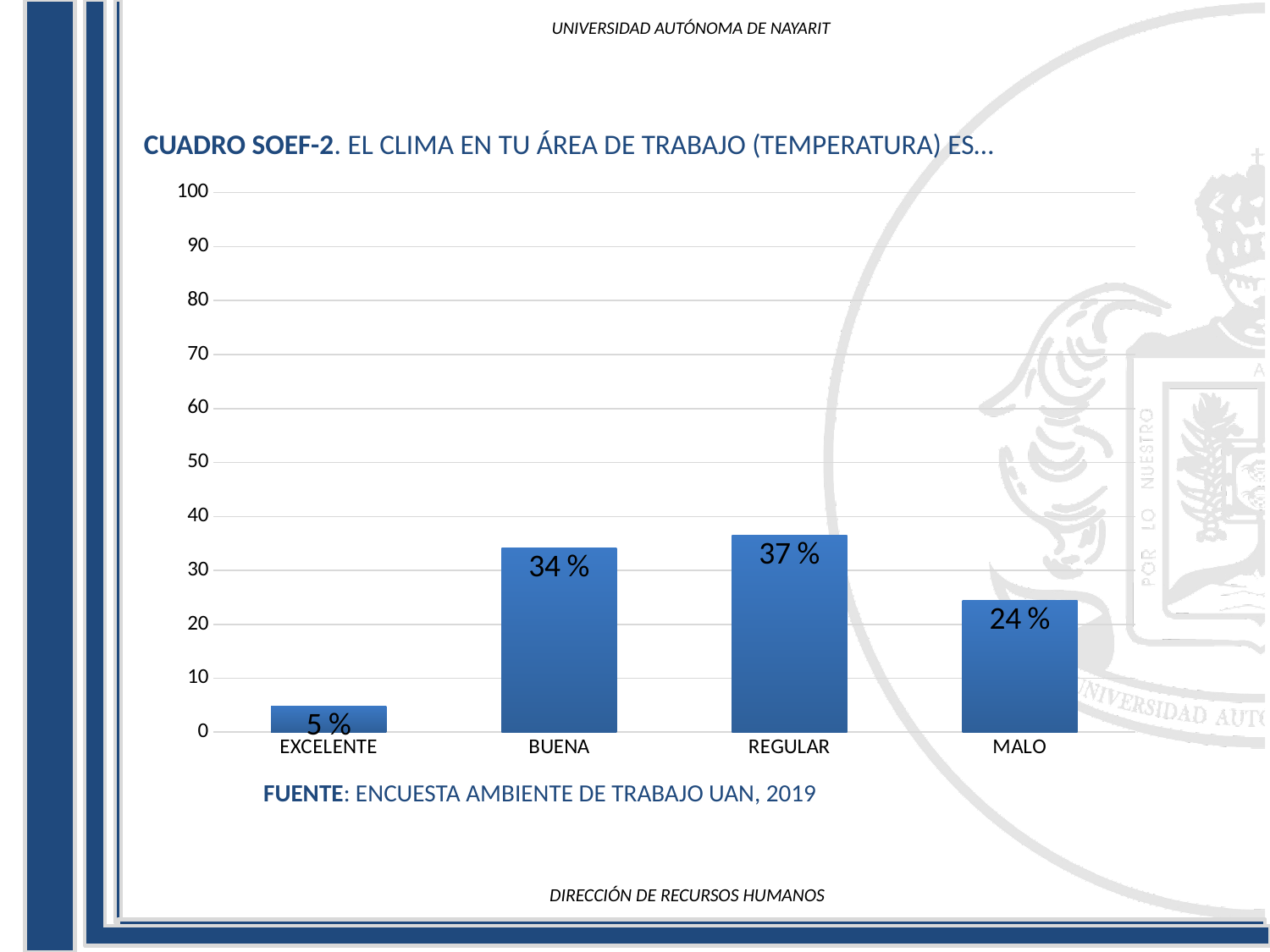
Which category has the highest value? REGULAR What is the total of the values for EXCELENTE and BUENA? 39 % Which is larger, the value for BUENA or the value for MALO? BUENA How many categories are shown on the x axis? 4 Is the value for REGULAR greater or less than 40? less Which category has the lowest value? EXCELENTE What kind of chart is shown on the slide? bar chart What is the difference between the values for REGULAR and MALO? 13 % What source is cited below the chart? ENCUESTA AMBIENTE DE TRABAJO UAN, 2019 What is the value for BUENA? 34 % What is the value for MALO? 24 % What is the value for EXCELENTE? 5 %